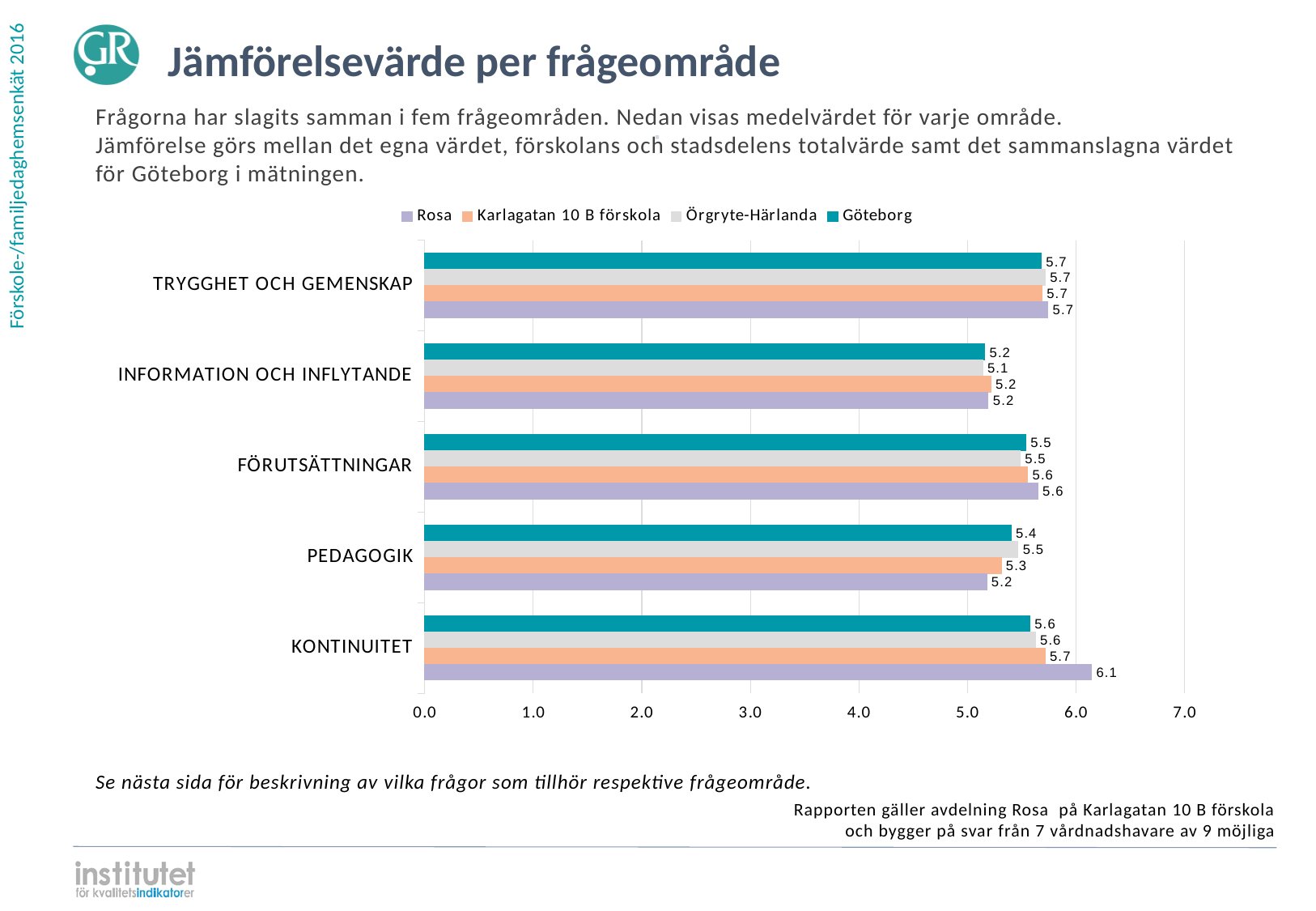
What is the value for Örgryte-Härlanda in the INFORMATION OCH INFLYTANDE category? 5.1 How many categories are shown on the y axis of the chart? 5 What is the difference between the Rosa value and the Göteborg value in the KONTINUITET category? 0.5 What is the value for Karlagatan 10 B förskola in the FÖRUTSÄTTNINGAR category? 5.6 What is the value for Rosa in the KONTINUITET category? 6.1 What kind of chart is shown on the slide? Bar chart In which category does Rosa have its lowest value? INFORMATION OCH INFLYTANDE and PEDAGOGIK What is the value for Göteborg in the PEDAGOGIK category? 5.4 In which category does Rosa have its highest value? KONTINUITET Is the value for Rosa in the KONTINUITET category greater or less than 6.0? greater How many series does the legend list? 4 In the PEDAGOGIK category, which is larger: the value for Örgryte-Härlanda or the value for Rosa? Örgryte-Härlanda